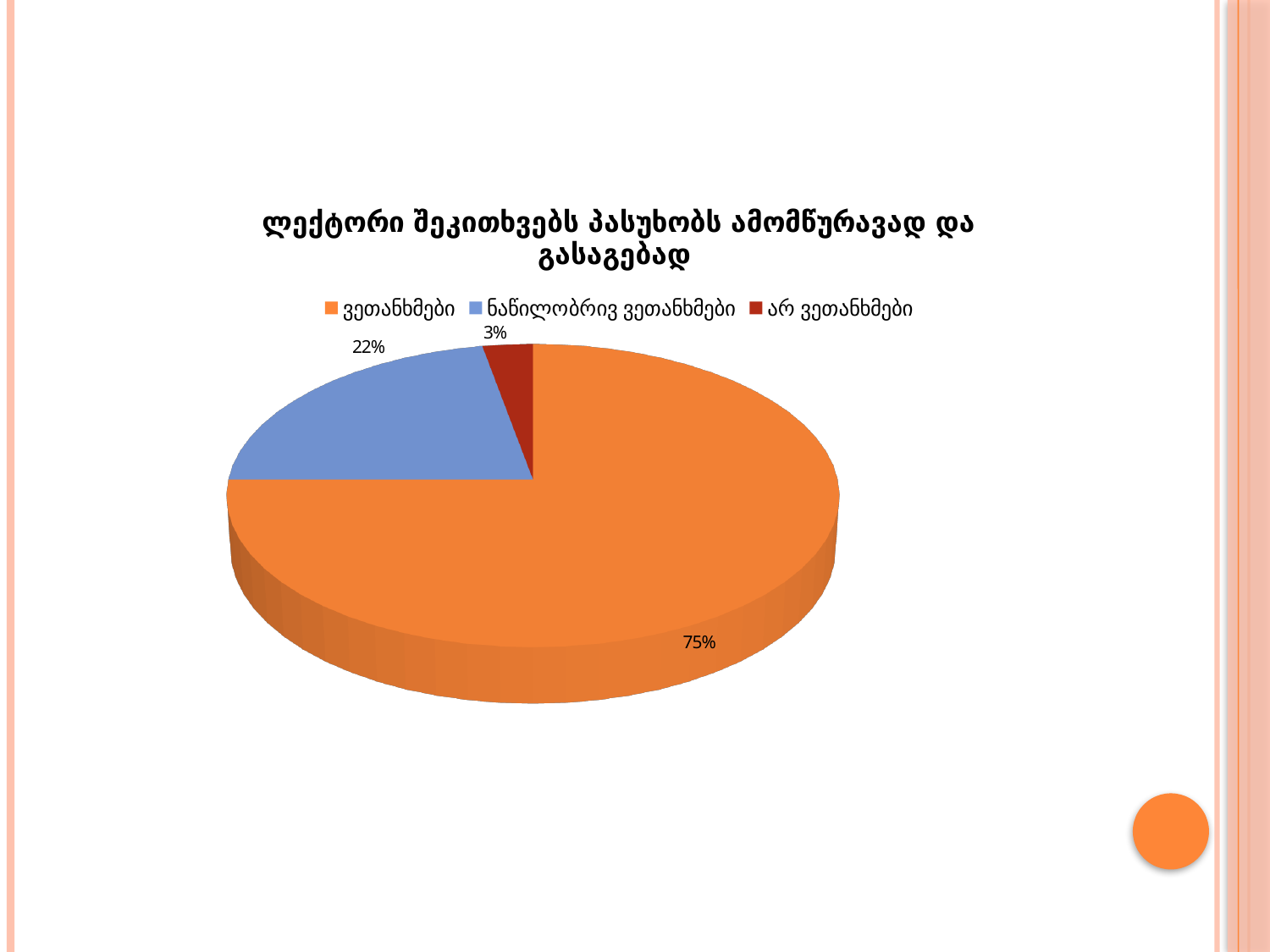
What is the value for ვეთანხმები? 75% What is the difference between the shares for ვეთანხმები and ნაწილობრივ ვეთანხმები? 53% What is the difference between the shares for ნაწილობრივ ვეთანხმები and არ ვეთანხმები? 19% What is the value for არ ვეთანხმები? 3% How many entries does the legend list? 3 What is the value for ნაწილობრივ ვეთანხმები? 22% Which category has the smallest share of the pie? არ ვეთანხმები How many slices does the pie chart have? 3 Which is larger, the share for ნაწილობრივ ვეთანხმები or the share for არ ვეთანხმები? ნაწილობრივ ვეთანხმები What kind of chart is shown on the slide? Pie chart Which category has the largest share of the pie? ვეთანხმები What colour is the slice for არ ვეთანხმები? Dark red